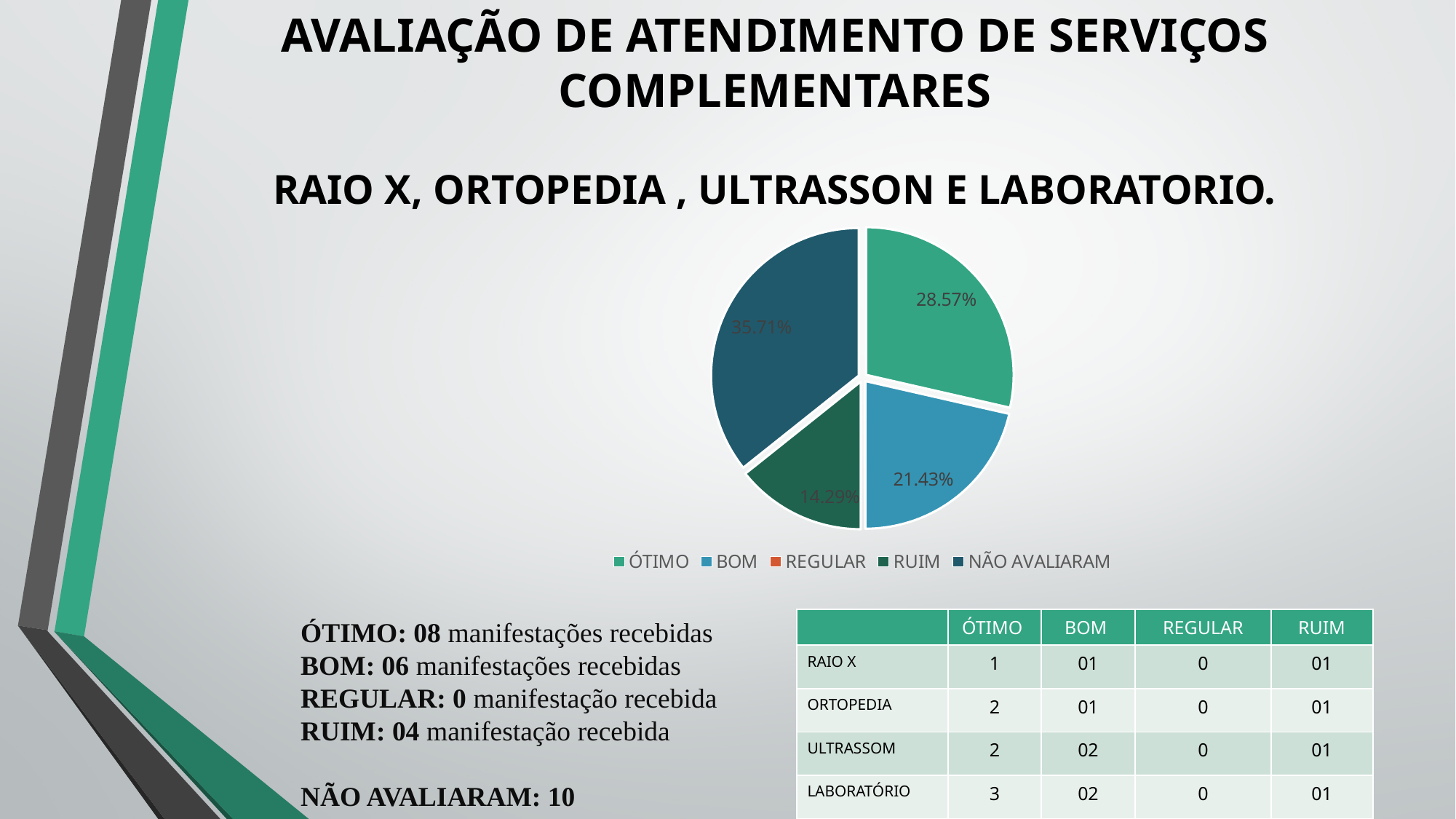
Which slice is larger, ÓTIMO or BOM? ÓTIMO What share of the pie does the ÓTIMO slice represent? 28.57% How many entries does the legend list? 5 What colour is the ÓTIMO slice in the pie chart? green Which legend category has no visible slice in the pie? REGULAR Which category has the largest slice of the pie? NÃO AVALIARAM What share of the pie does the NÃO AVALIARAM slice represent? 35.71% Which category with a visible slice has the smallest share of the pie? RUIM What share of the pie does the BOM slice represent? 21.43% What kind of chart is shown on the slide? pie chart What is the difference in percentage points between the NÃO AVALIARAM slice and the ÓTIMO slice? 7.14